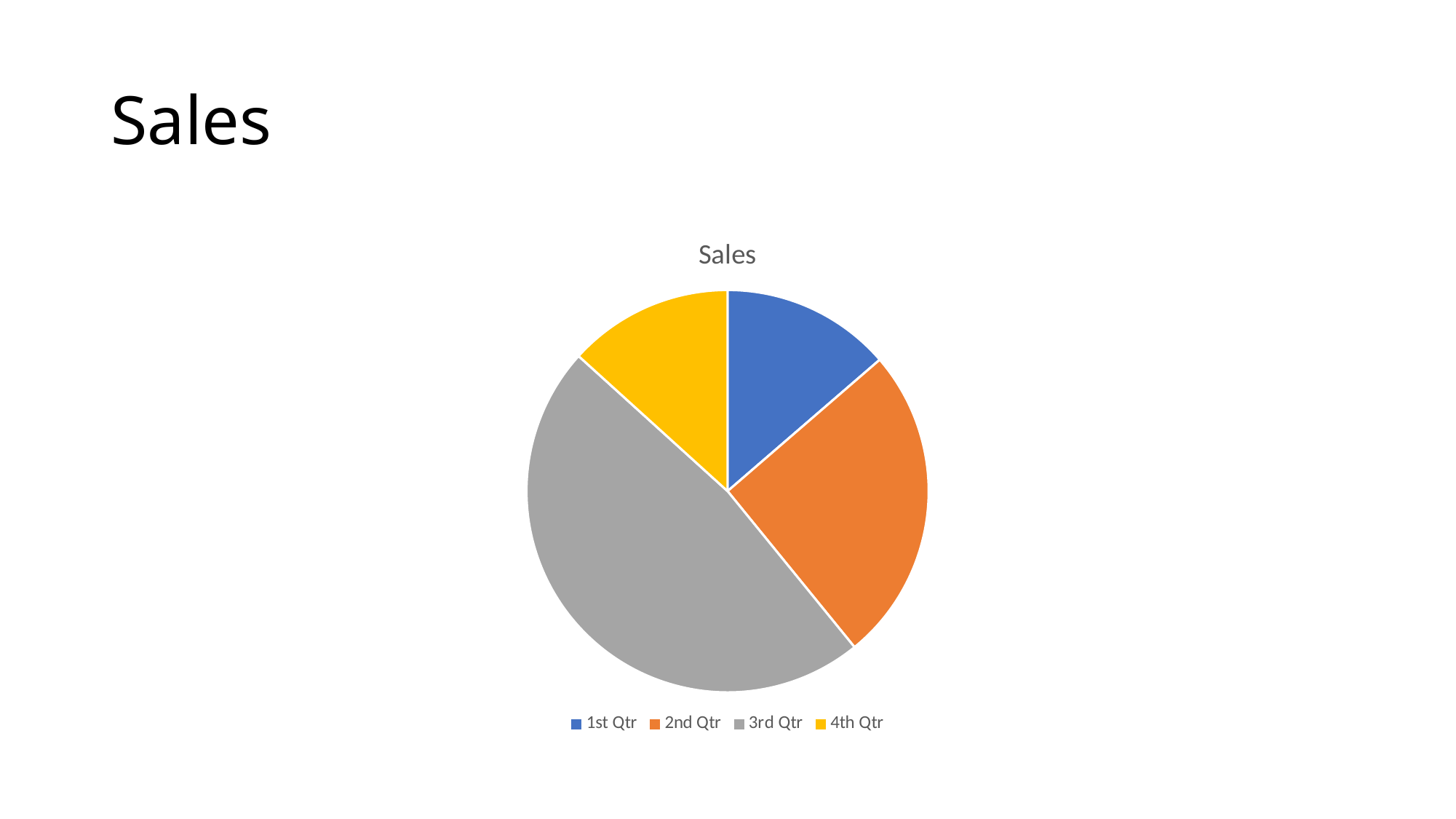
Which is larger, the slice for 3rd Qtr or the slice for 4th Qtr? 3rd Qtr What kind of chart is shown on the slide? pie chart What is the title of the chart? Sales Which is larger, the slice for 3rd Qtr or the slice for 2nd Qtr? 3rd Qtr Which quarter has the largest slice of the pie? 3rd Qtr Which is larger, the slice for 2nd Qtr or the slice for 4th Qtr? 2nd Qtr How many slices does the pie chart have? 4 Which colour represents 3rd Qtr in the pie chart? gray How many entries does the legend list? 4